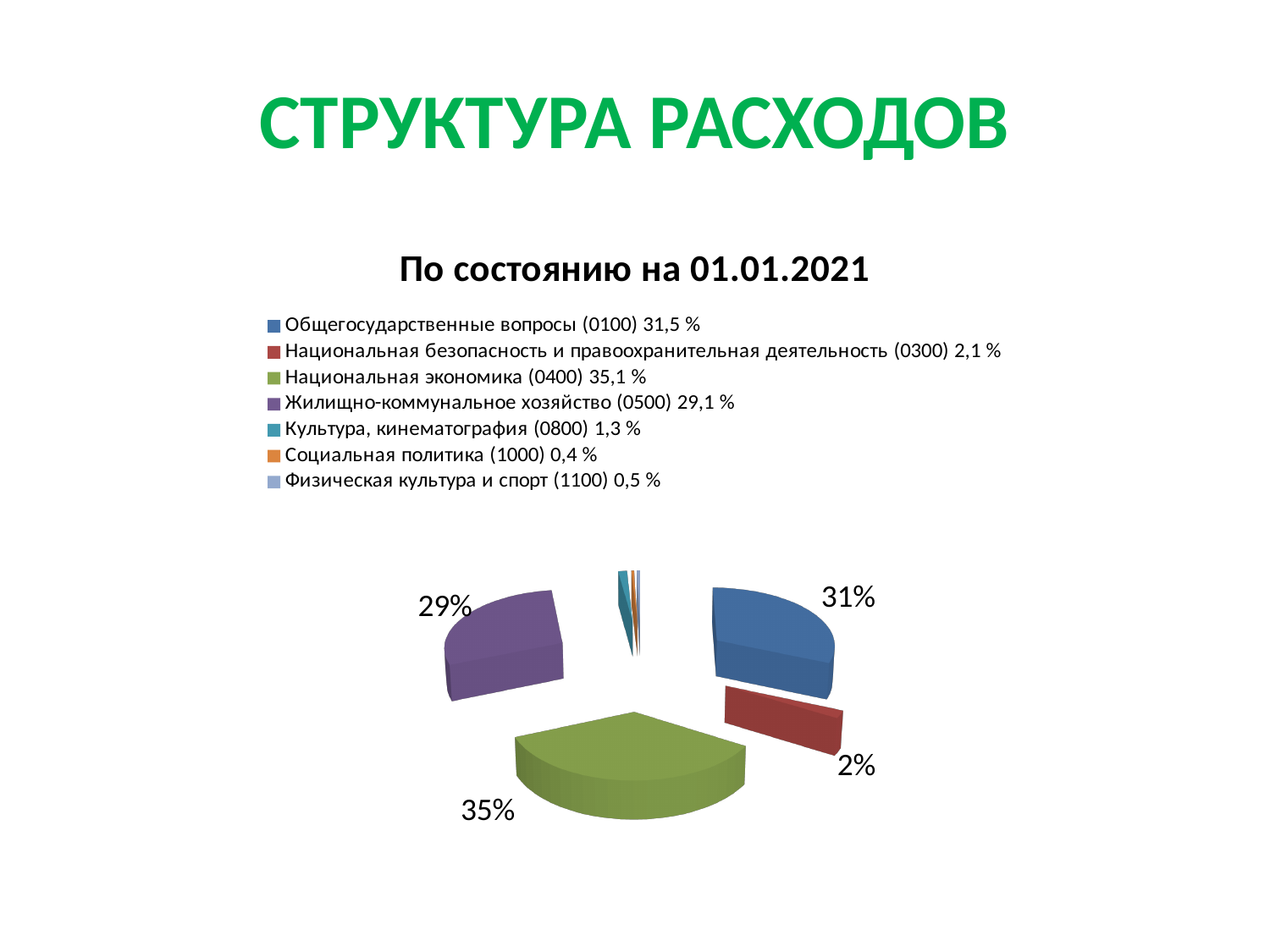
Using the legend values, what is the difference between the shares of Национальная экономика (0400) and Общегосударственные вопросы (0100)? 3,6 % According to the legend, what share does Национальная экономика (0400) have? 35,1 % How many categories does the legend list? 7 Which category has the largest share? Национальная экономика (0400) Which category has the smallest share? Социальная политика (1000) According to the legend, what share does Культура, кинематография (0800) have? 1,3 % What data label is shown on the green slice of the pie? 35% What data label is shown on the red slice of the pie? 2% According to the legend, what share does Жилищно-коммунальное хозяйство (0500) have? 29,1 % What kind of chart is shown on the slide? Pie chart What is the chart's title? По состоянию на 01.01.2021 According to the legend, what share does Общегосударственные вопросы (0100) have? 31,5 %